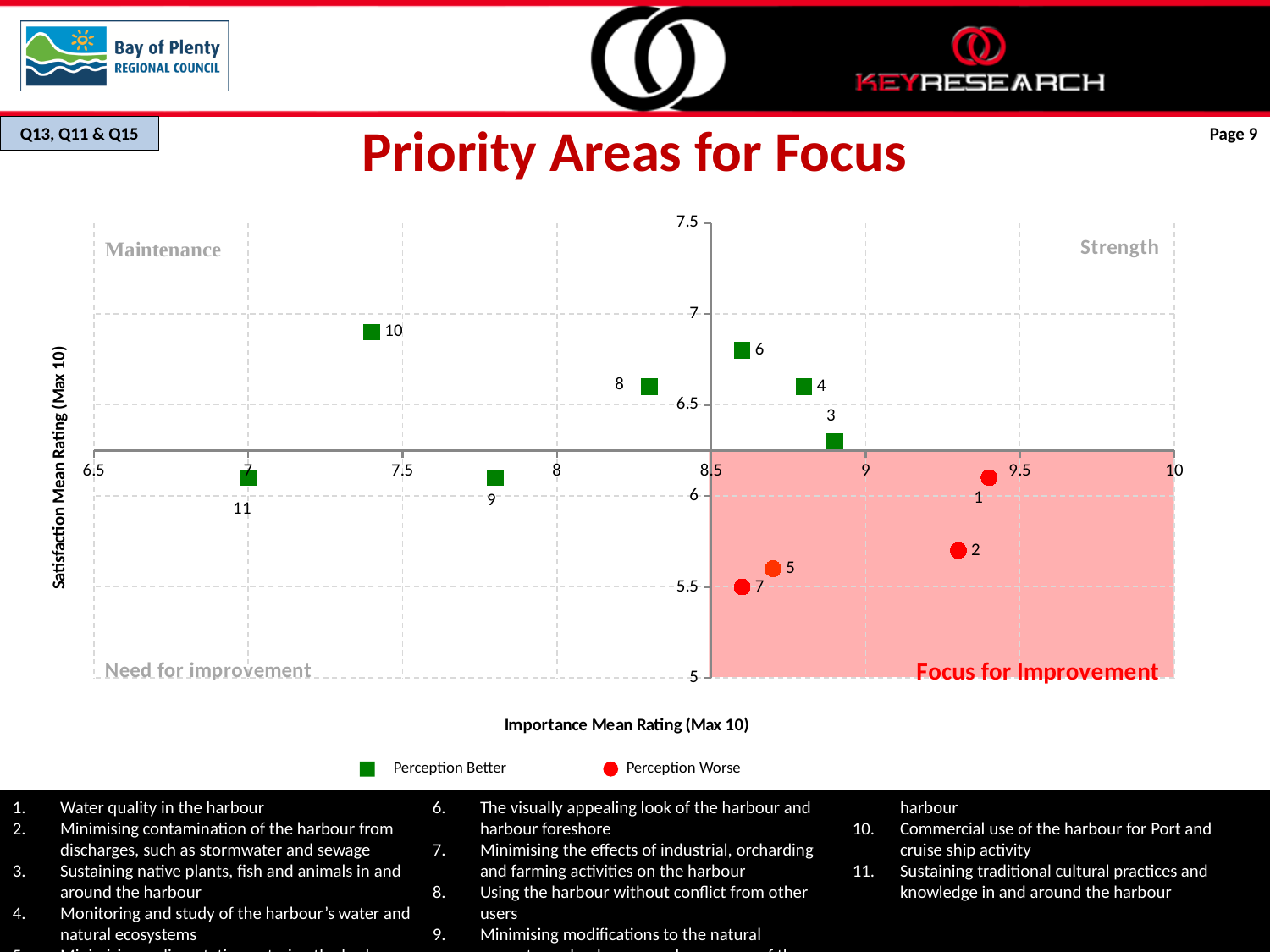
Is the Importance Mean Rating for point 1 greater or less than 9? greater What label is shown in the shaded bottom-right quadrant of the chart? Focus for Improvement Which has the higher Satisfaction Mean Rating, point 10 or point 7? Point 10 Is the Satisfaction Mean Rating for point 10 greater or less than 6.5? greater Which numbered point has the lowest Importance Mean Rating? 11 What kind of chart is shown on the slide? Scatter chart How many numbered points are plotted on the chart? 11 How many points are plotted as red circles (Perception Worse)? 4 Is the Satisfaction Mean Rating for point 7 greater or less than 6? less Which numbered point has the highest Satisfaction Mean Rating? 10 How many series does the legend list? 2 What is the title of the chart? Priority Areas for Focus